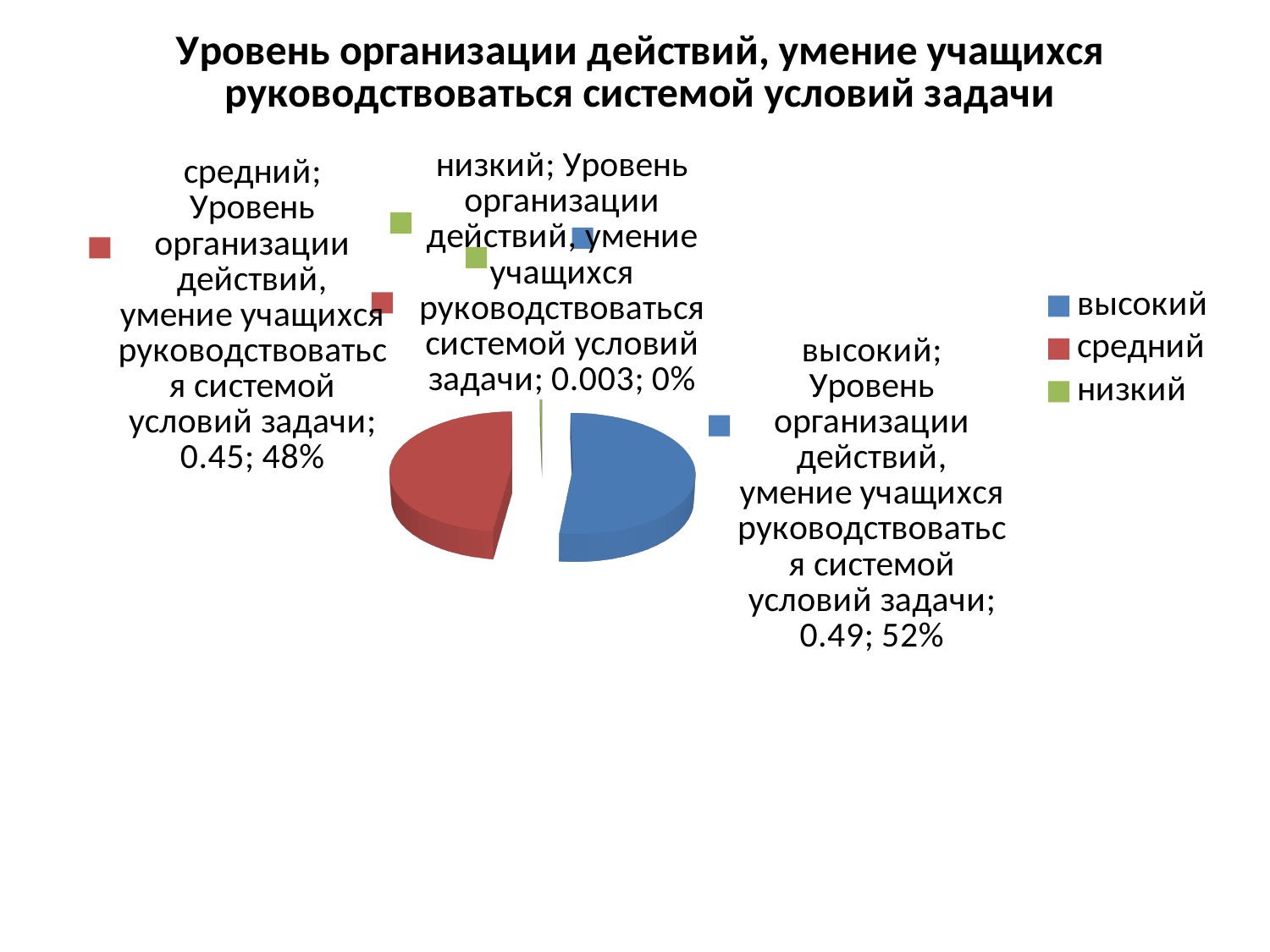
What is the value for the "высокий" slice? 0.49 Which category has the smallest slice of the pie? низкий What percentage share of the pie does the "средний" slice have? 48% What kind of chart is shown on the slide? pie chart What is the difference between the values for "высокий" and "средний"? 0.04 What is the value for the "средний" slice? 0.45 How many categories does the legend list? 3 What is the value for the "низкий" slice? 0.003 Which category has the largest slice of the pie? высокий What colour is the "средний" slice? red What percentage share of the pie does the "высокий" slice have? 52% What percentage share of the pie does the "низкий" slice have? 0%